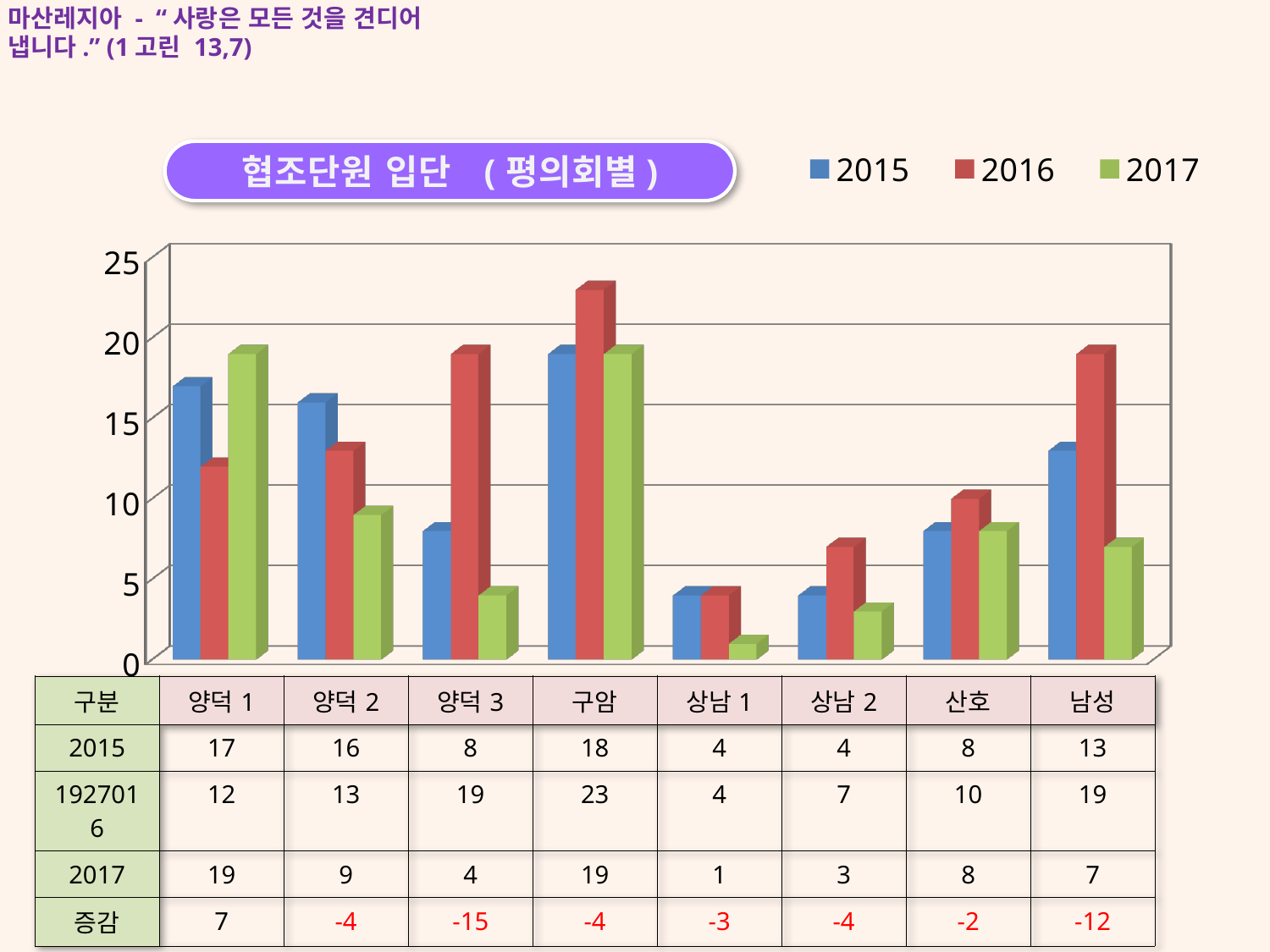
What is the 2017 value for 양덕 1? 19 What type of chart is shown on the slide? bar chart Is the 2016 value for 구암 greater or less than 20? greater How many categories (평의회) are shown on the x axis? 8 How many series does the legend list? 3 What is the difference between the 2016 and 2017 values for 양덕 3? 15 What is the 2016 value for 구암? 23 Which category has the lowest 2017 value? 상남 1 What is the title of the chart? 협조단원 입단 (평의회별) What is the 2015 value for 남성? 13 Which category has the highest 2016 value? 구암 Which is larger for 남성, the 2016 value or the 2017 value? 2016